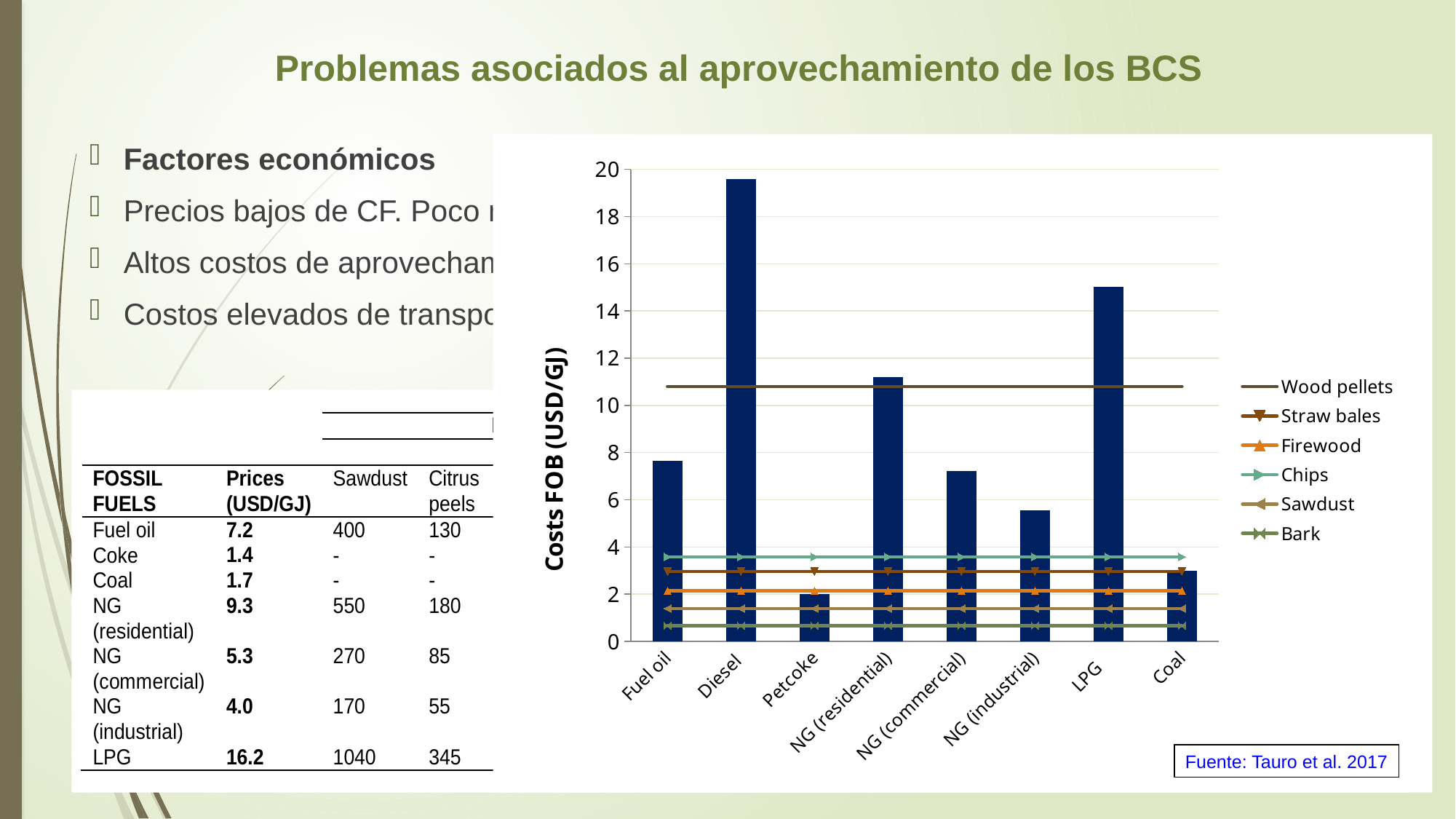
Which has a higher bar, Diesel or LPG? Diesel Is the bar for Diesel greater or less than 18? greater How many series does the chart's legend list? 6 Which legend entry is listed first in the chart's legend? Wood pellets Is the bar for Petcoke greater or less than 4? less Is the bar for LPG greater or less than 14? greater Which fuel has the lowest bar in the chart? Petcoke What kind of chart is shown on the slide? Bar and line chart What is the title of the chart's vertical axis? Costs FOB (USD/GJ) Which fuel has the highest bar in the chart? Diesel How many fuel categories are shown along the x axis of the chart? 8 Which has a higher bar, NG (residential) or NG (commercial)? NG (residential)